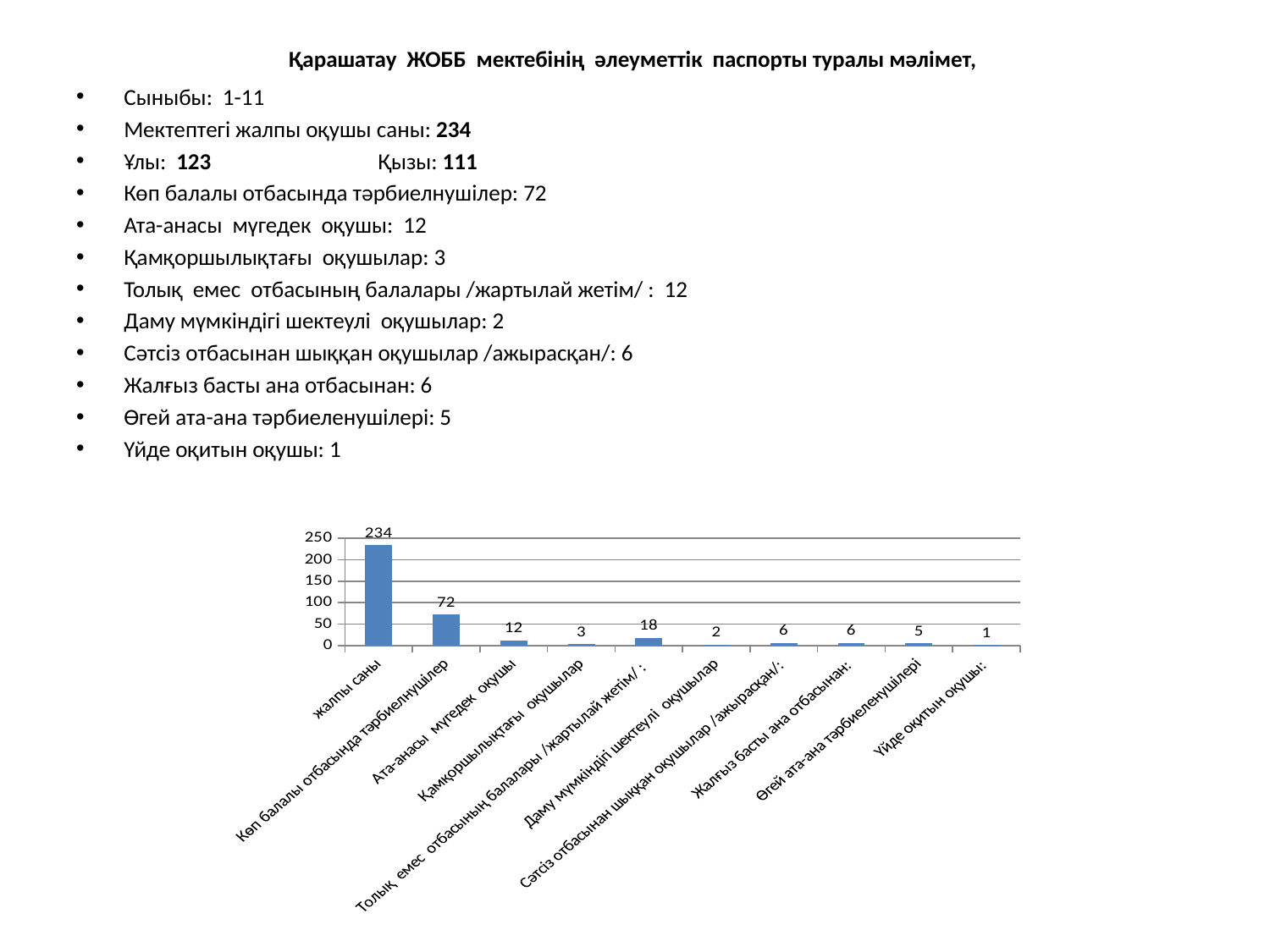
What is the value for "Өгей ата-ана тәрбиеленушілері" in the chart? 5 How many categories are shown in the chart? 10 What is the value for "жалпы саны" in the chart? 234 Which category has the highest value in the chart? жалпы саны What is the difference between the values for "жалпы саны" and "Көп балалы отбасында тәрбиелнушілер"? 162 What is the difference between the values for "Толық емес отбасының балалары /жартылай жетім/" and "Ата-анасы мүгедек оқушы"? 6 What is the value for "Толық емес отбасының балалары /жартылай жетім/" in the chart? 18 Is the value for "Көп балалы отбасында тәрбиелнушілер" greater or less than 100? less Which category has the lowest value in the chart? Үйде оқитын оқушы Which is larger: the value for "Ата-анасы мүгедек оқушы" or the value for "Қамқоршылықтағы оқушылар"? Ата-анасы мүгедек оқушы What is the value for "Көп балалы отбасында тәрбиелнушілер" in the chart? 72 What kind of chart is shown on the slide? bar chart